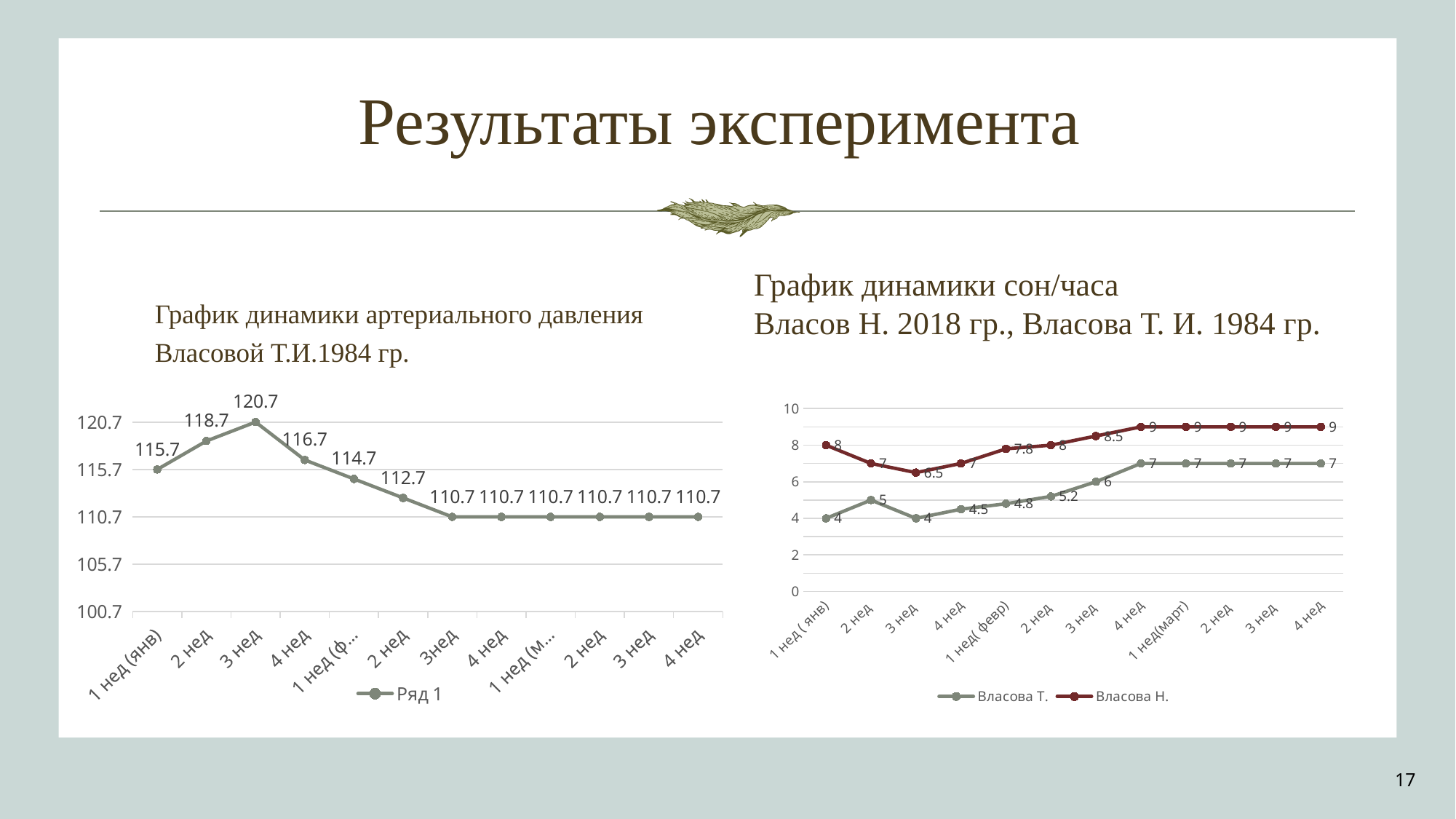
In the left chart (График динамики артериального давления), which category has the highest value? 3 нед In the left chart (График динамики артериального давления), how many data points are plotted? 12 In the right chart (График динамики сон/часа), which series has the larger value at 1 нед (янв)? Власова Н. In the right chart (График динамики сон/часа), what is the difference between Власова Н. and Власова Т. at 4 нед(март)? 2 In the right chart (График динамики сон/часа), what is the value for Власова Н. at 3 нед in the first group of weeks? 6.5 In the left chart (График динамики артериального давления), what is the value for 1 нед (янв)? 115.7 In the right chart (График динамики сон/часа), how many series does the legend list? 2 In the right chart (График динамики сон/часа), what is the value for Власова Т. at 1 нед( февр)? 4.8 In the right chart (График динамики сон/часа), what is the name of the series drawn in dark red? Власова Н. In the left chart (График динамики артериального давления), what type of chart is shown? line chart